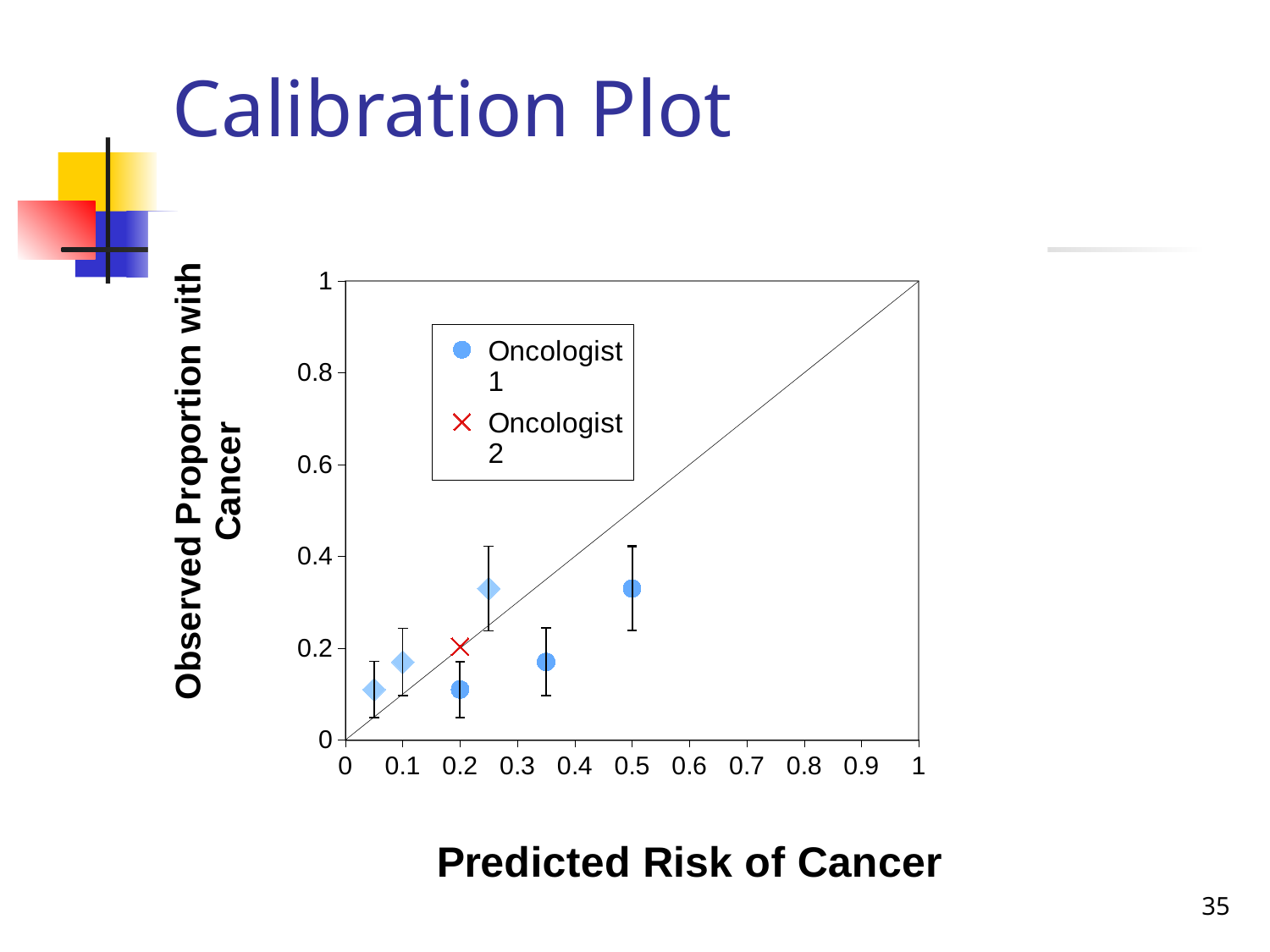
Is the observed proportion for the Oncologist 2 point greater or less than 0.4? less Is the observed proportion for the Oncologist 1 point at predicted risk 0.2 greater or less than 0.2? less What kind of chart is shown on the slide? scatter plot At predicted risk 0.2, which has the higher observed proportion: Oncologist 1 or Oncologist 2? Oncologist 2 How many series does the legend list? 2 How many Oncologist 2 (X) points are plotted? 1 Is the observed proportion for the Oncologist 1 point at predicted risk 0.5 greater or less than 0.2? greater What are the two series named in the legend? Oncologist 1 and Oncologist 2 How many Oncologist 1 (circle) points are plotted? 3 Which Oncologist 1 point has the highest observed proportion: the one at predicted risk 0.2, 0.35 or 0.5? 0.5 What is the title of the x axis? Predicted Risk of Cancer